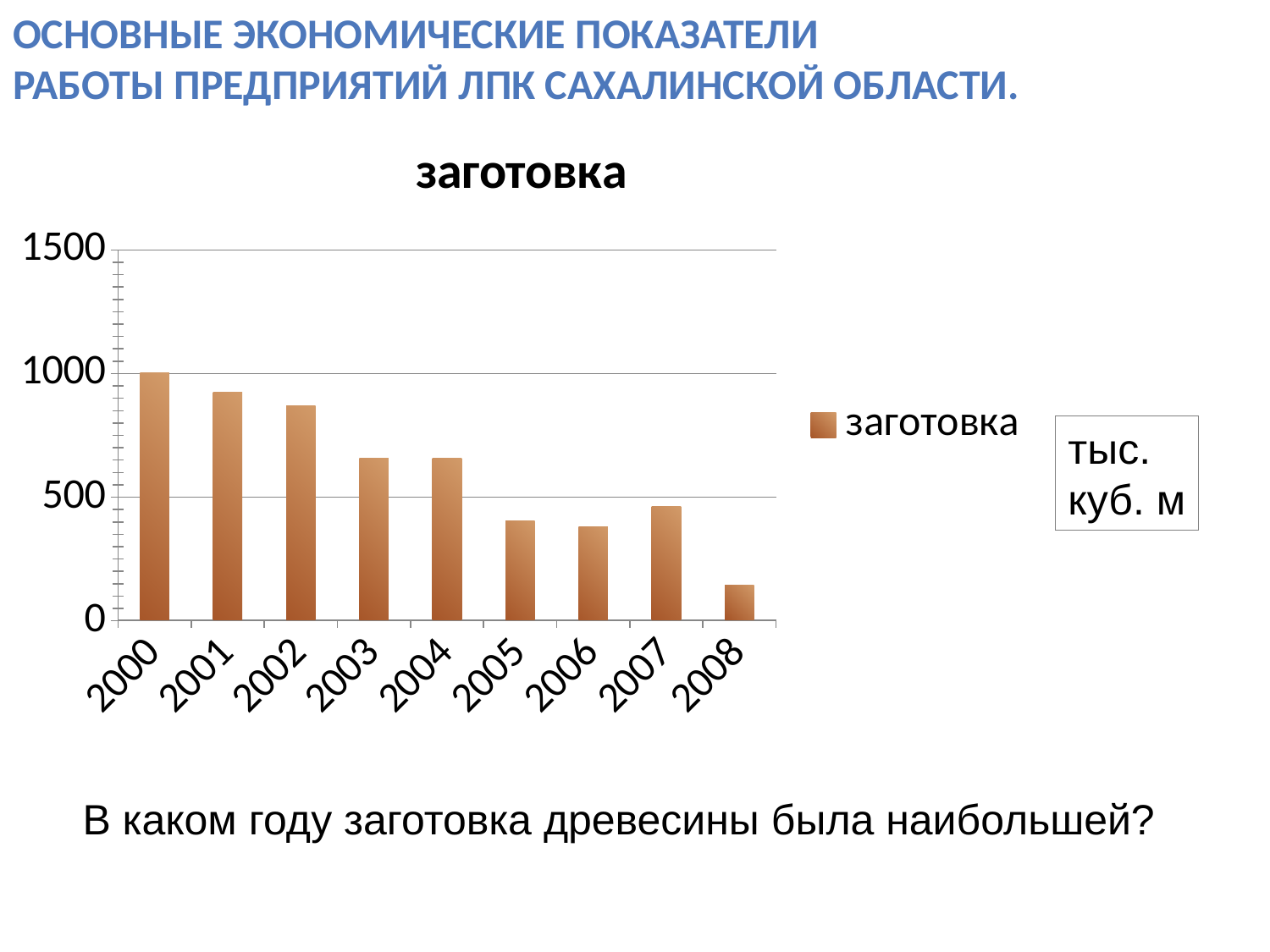
What unit is indicated in the box next to the chart? тыс. куб. м In which year is the value of заготовка highest? 2000 What kind of chart is shown on the slide? bar chart Do the values generally rise or fall from 2000 to 2008? fall Is the value for 2005 greater or less than 500? less Is the value for 2001 greater or less than 500? greater How many years are shown on the x axis of the chart? 9 In which year is the value of заготовка lowest? 2008 How many series does the legend list? 1 Which year has the larger value, 2002 or 2007? 2002 Is the value for 2008 greater or less than 500? less What is the title of the chart? заготовка